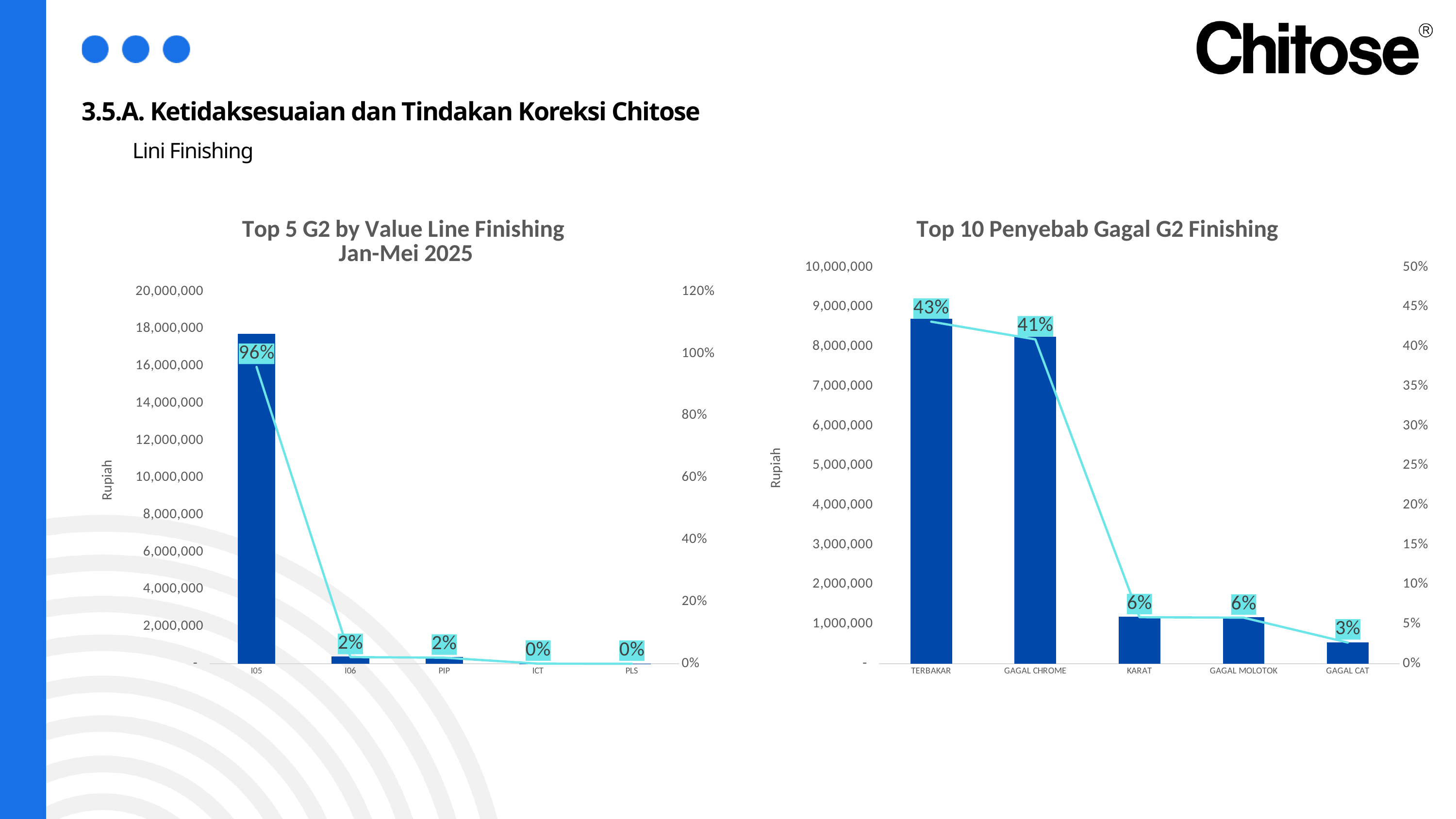
In the chart titled 'Top 5 G2 by Value Line Finishing Jan-Mei 2025', what percentage is labelled for I06? 2% In the chart titled 'Top 10 Penyebab Gagal G2 Finishing', what percentage is labelled for TERBAKAR? 43% In the chart titled 'Top 5 G2 by Value Line Finishing Jan-Mei 2025', is the bar value for I05 greater or less than 16,000,000? greater In the chart titled 'Top 10 Penyebab Gagal G2 Finishing', which category has the lowest bar? GAGAL CAT In the chart titled 'Top 5 G2 by Value Line Finishing Jan-Mei 2025', how many categories are shown on the x axis? 5 In the chart titled 'Top 10 Penyebab Gagal G2 Finishing', is the bar value for GAGAL CAT greater or less than 1,000,000? less In the chart titled 'Top 10 Penyebab Gagal G2 Finishing', what is the difference between the percentage labels for TERBAKAR and GAGAL CHROME? 2% In the chart titled 'Top 10 Penyebab Gagal G2 Finishing', what is the label on the left vertical axis? Rupiah In the chart titled 'Top 5 G2 by Value Line Finishing Jan-Mei 2025', what is the difference between the percentage labels for I05 and I06? 94% In the chart titled 'Top 5 G2 by Value Line Finishing Jan-Mei 2025', which category has the highest bar? I05 In the chart titled 'Top 10 Penyebab Gagal G2 Finishing', what percentage is labelled for GAGAL CAT? 3% In the chart titled 'Top 5 G2 by Value Line Finishing Jan-Mei 2025', what percentage is labelled for I05? 96%